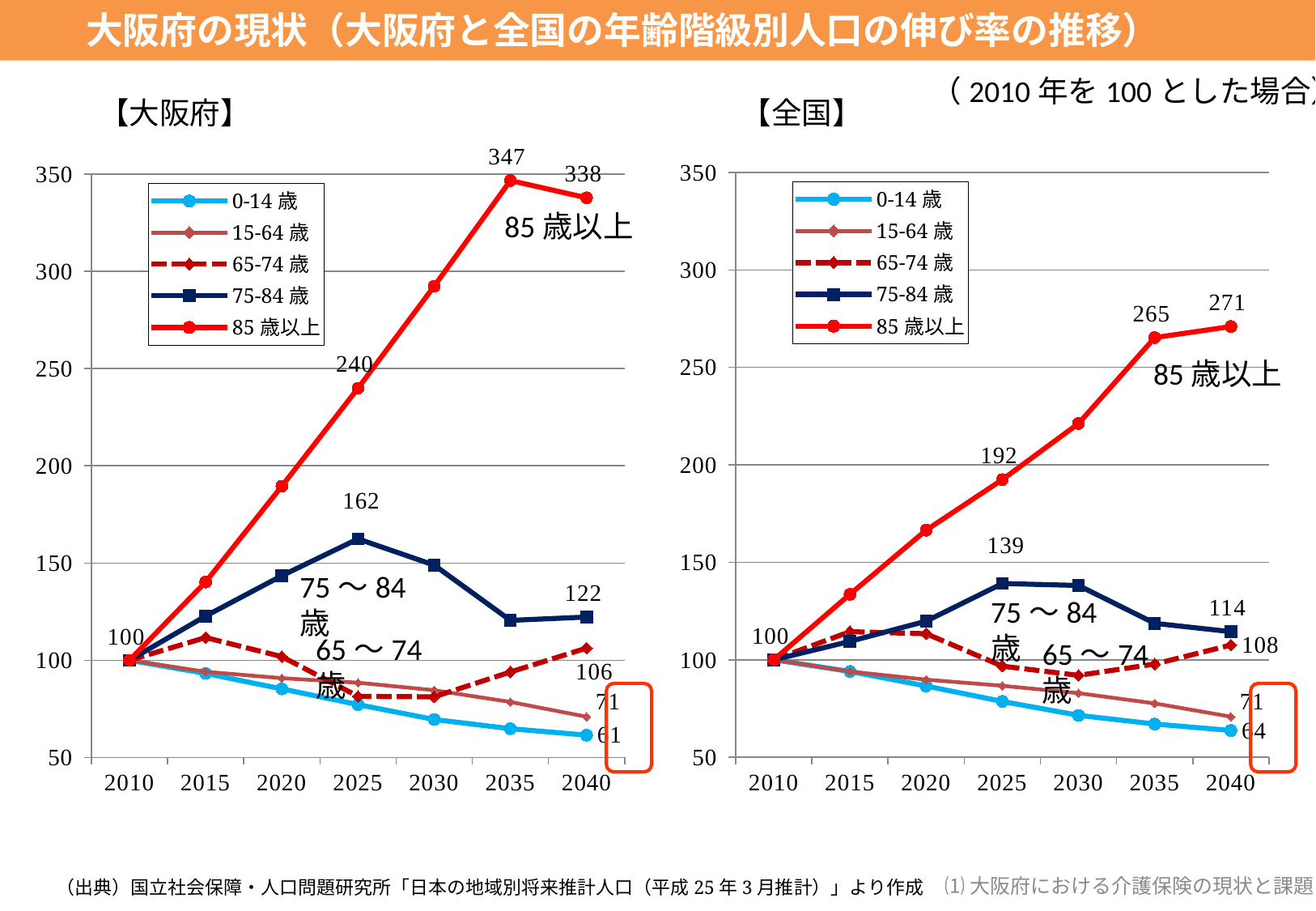
In the 【全国】 chart, what is the value of the 85歳以上 series in 2040? 271 What type of chart is the 【全国】 chart? Line chart In the 【大阪府】 chart, what is the value of the 85歳以上 series in 2035? 347 How many series does the legend of the 【大阪府】 chart list? 5 In the 【全国】 chart, which series has the lowest value in 2040? 0-14歳 In the 【大阪府】 chart, what is the value of the 75-84歳 series in 2025? 162 Which is larger: the 2040 value of 75-84歳 in the 【大阪府】 chart or in the 【全国】 chart? 大阪府 (122) In the 【大阪府】 chart, which series has the highest value in 2040? 85歳以上 In the 【大阪府】 chart, what is the difference between the 85歳以上 values in 2035 and 2040? 9 In the 【全国】 chart, is the value of the 85歳以上 series in 2030 greater or less than 200? greater In the 【大阪府】 chart, does the 0-14歳 series rise or fall from 2010 to 2040? Fall In the 【全国】 chart, what is the value of the 0-14歳 series in 2040? 64